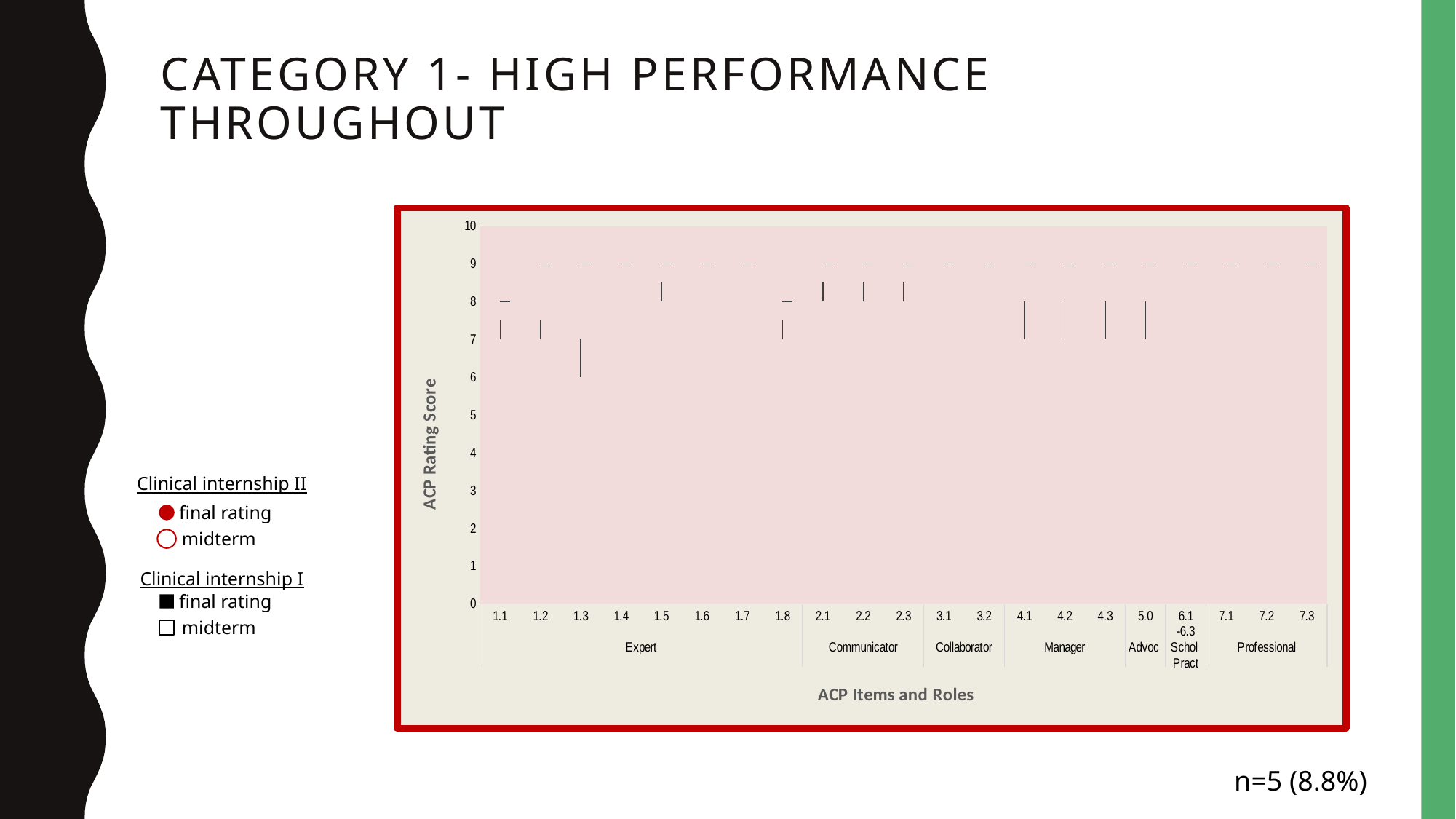
Among the Expert items, which item has the lowest mark on the chart? 1.3 Is the mark for item 7.2 greater or less than 8? greater What is the title of the horizontal axis of the chart? ACP Items and Roles What is the title of the vertical axis of the chart? ACP Rating Score Is the highest mark for item 1.3 greater or less than 8? greater What is the maximum value shown on the ACP Rating Score axis? 10 How many role groups (such as Expert, Communicator) are labelled along the x axis? 7 Is the lowest mark for item 4.1 greater or less than 5? greater How many ACP items are listed along the x axis of the chart? 21 What score is marked for item 1.4? 9 How many items are grouped under the Expert role on the x axis? 8